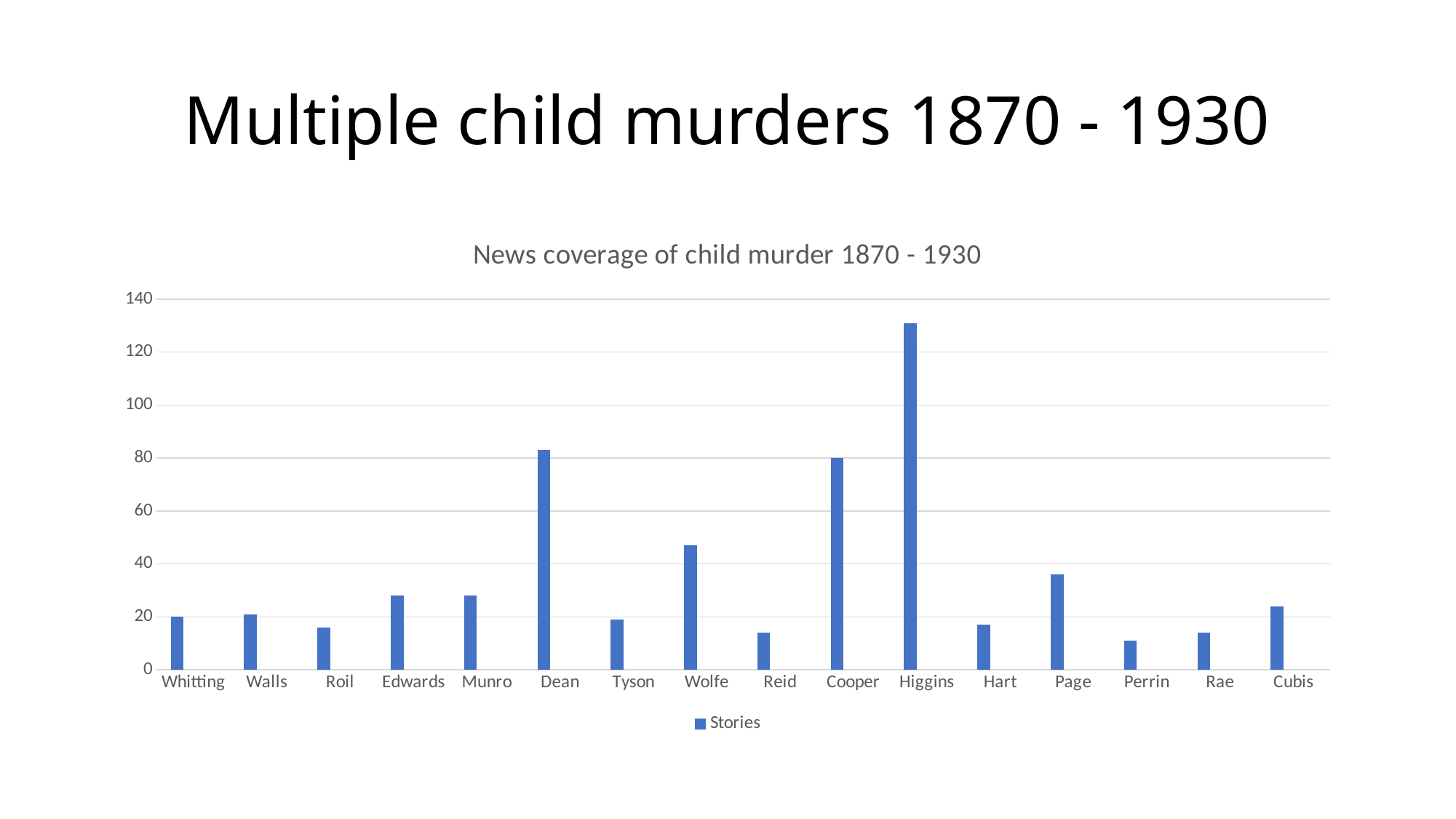
Is the value for Wolfe greater or less than 60? less Is the value for Higgins greater or less than 120? greater What is the title of the chart? News coverage of child murder 1870 - 1930 Which is larger, the value for Higgins or the value for Cooper? Higgins How many categories are shown on the x axis? 16 How many series does the legend list? 1 Which category has the highest value? Higgins Is the value for Dean greater or less than 60? greater What is the name of the series shown in the legend? Stories Which is larger, the value for Wolfe or the value for Page? Wolfe What kind of chart is shown on the slide? bar chart Which category has the lowest value? Perrin